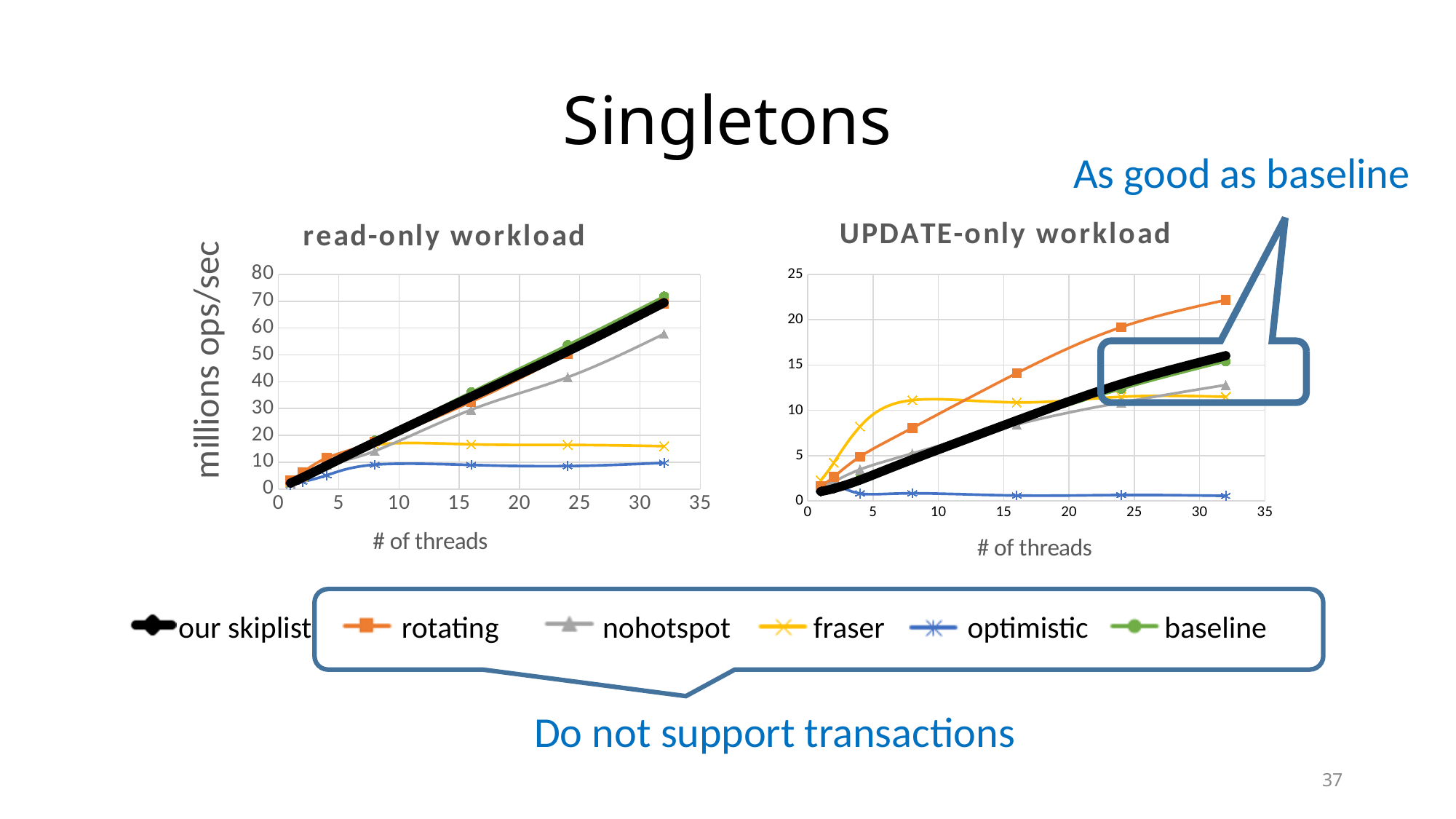
In the "UPDATE-only workload" chart, is the value for rotating at 32 threads greater or less than 20? greater In the "read-only workload" chart, which series has the lowest value at 32 threads? optimistic In the "read-only workload" chart, is the value for fraser at 32 threads greater or less than 20? less What kind of chart is the "read-only workload" chart? line chart In the "UPDATE-only workload" chart, which series has the highest value at 32 threads? rotating In the "read-only workload" chart, does the value for our skiplist rise or fall as the number of threads increases? rise What is the y-axis label of the "read-only workload" chart? millions ops/sec In the "UPDATE-only workload" chart, is the value for optimistic at 32 threads greater or less than 5? less How many series does the legend list? 6 In the "UPDATE-only workload" chart, which series has the lowest value at 32 threads? optimistic In the "read-only workload" chart, which is larger at 32 threads: nohotspot or fraser? nohotspot